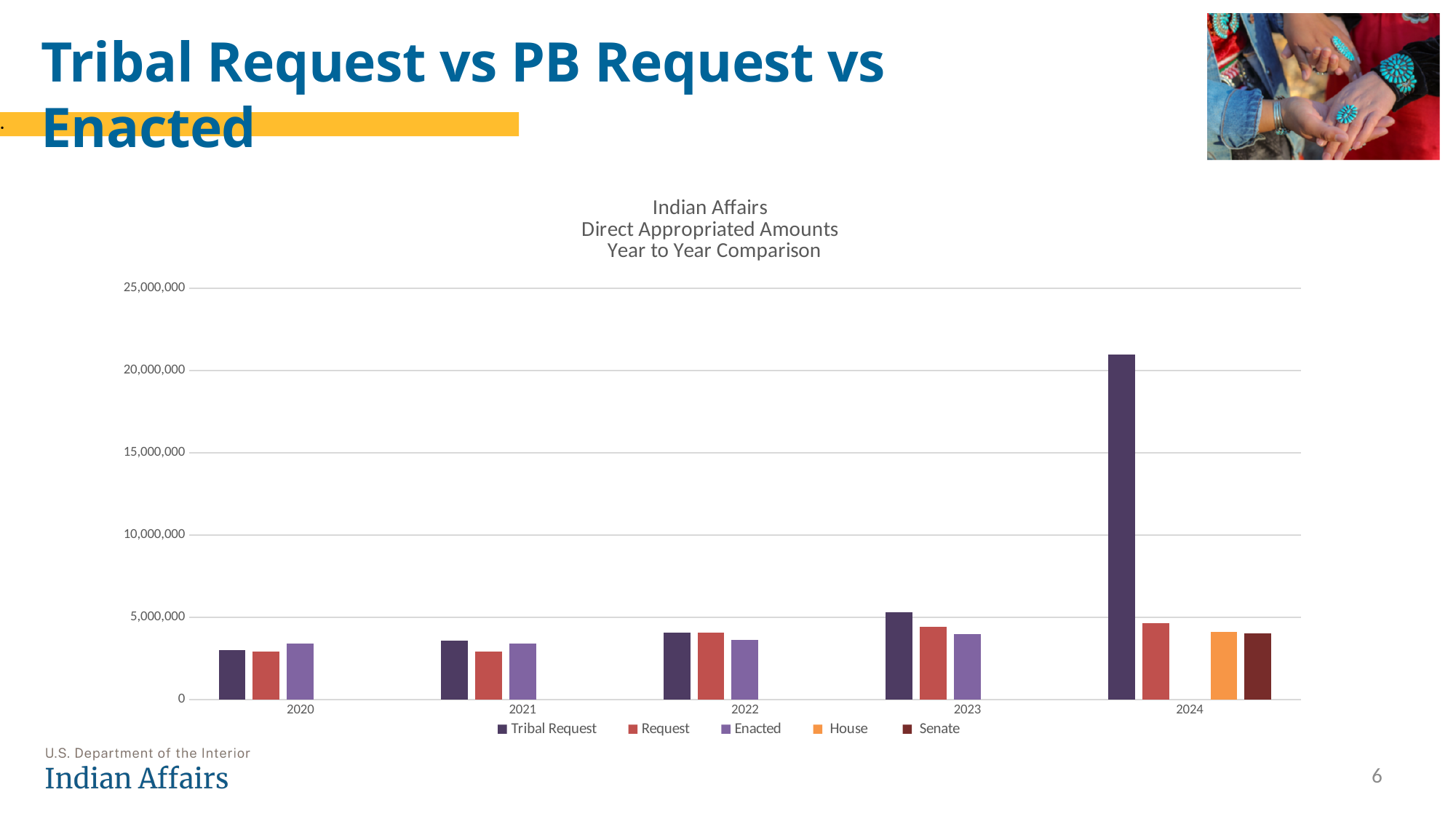
Which two legend series have bars only in 2024? House and Senate Is the Enacted value for 2020 greater or less than 5,000,000? less In which year is the Tribal Request bar the lowest? 2020 In which year is the Tribal Request bar the highest? 2024 In 2020, which is larger: the Enacted bar or the Tribal Request bar? Enacted Is the Tribal Request value for 2024 greater or less than 20,000,000? greater How many years are shown along the x axis of the chart? 5 How many series does the chart legend list? 5 Is the Request value for 2024 greater or less than 5,000,000? less What kind of chart is shown on the slide? Bar chart Does the Tribal Request series rise or fall from 2020 to 2024? Rise In 2021, which is larger: the Tribal Request bar or the Request bar? Tribal Request